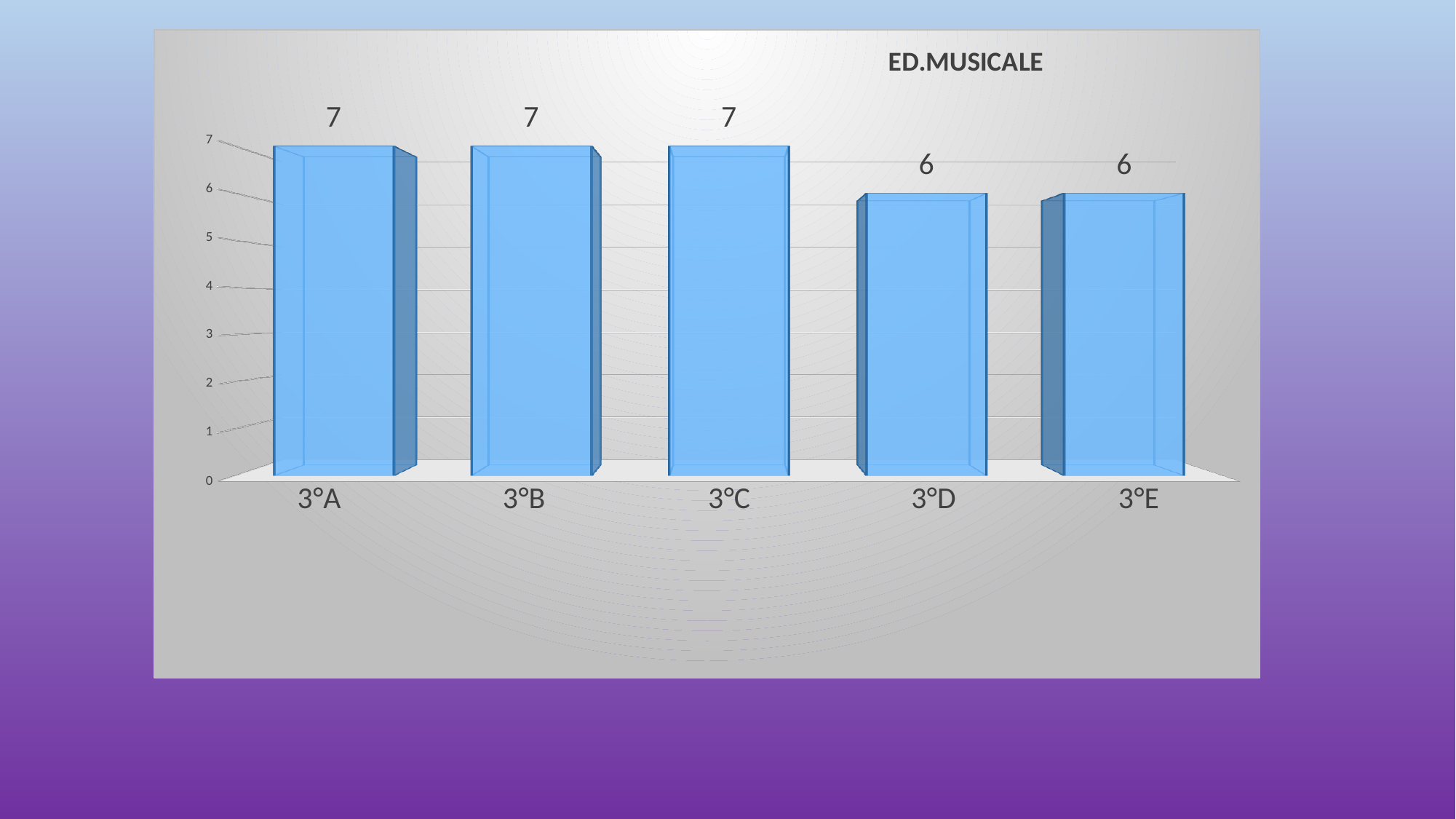
Which is larger, the value for 3°C or the value for 3°E? 3°C What is the value for 3°A? 7 How many categories are shown on the x axis? 5 Do the values rise or fall from 3°C to 3°D? fall Is the value for 3°D greater or less than 5? greater What is the title of the chart? ED.MUSICALE What kind of chart is shown on the slide? bar chart What is the value for 3°C? 7 What is the value for 3°D? 6 What colour are the bars in the chart? blue What is the difference between the values for 3°B and 3°D? 1 What is the value for 3°E? 6